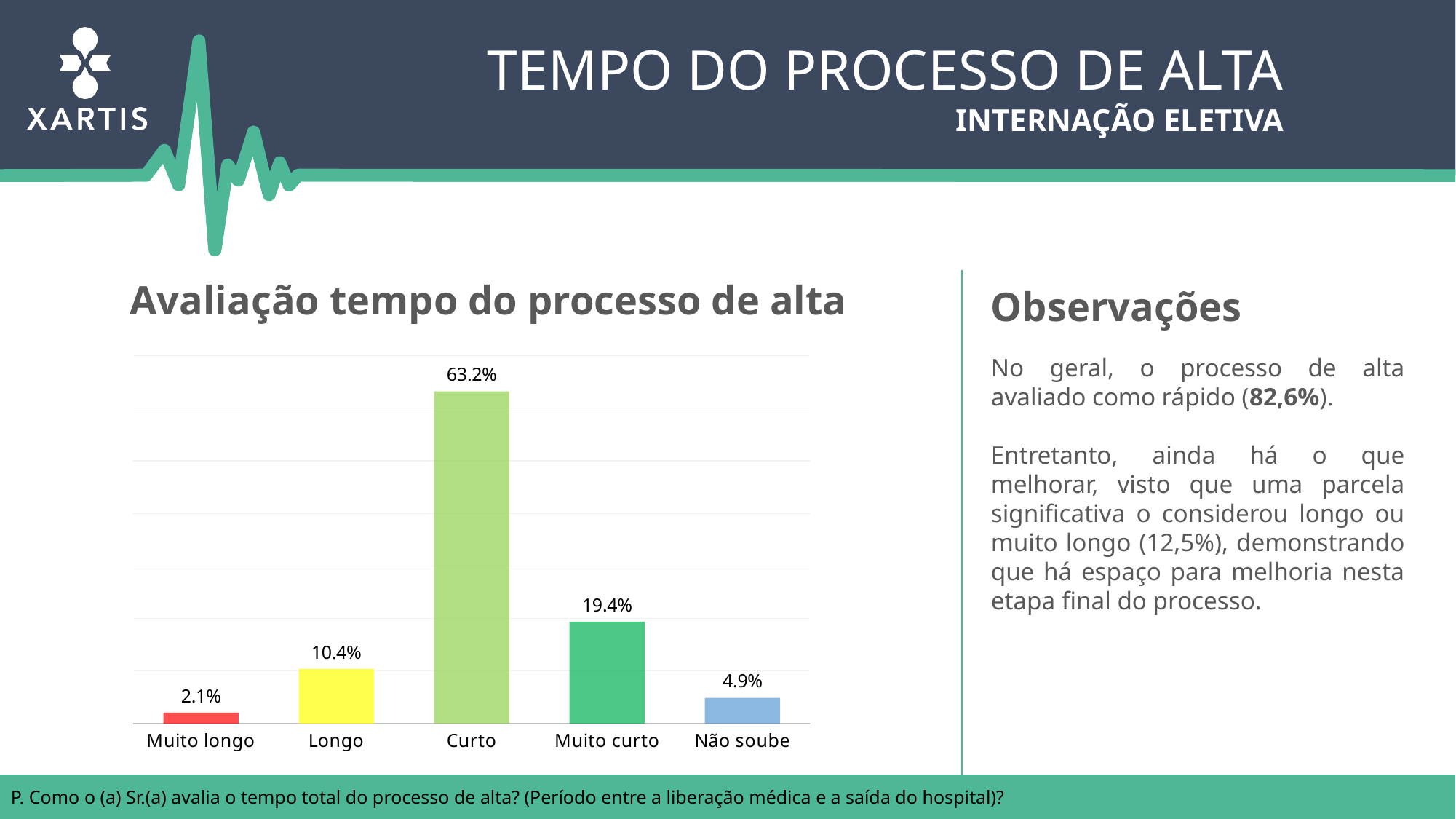
Which category has the highest value? Curto What is the difference between the values for Curto and Muito curto? 43.8% What is the value for Muito longo? 2.1% Which category has the lowest value? Muito longo What is the value for Curto? 63.2% What is the difference between the values for Longo and Muito longo? 8.3% What colour is the bar for Muito longo? Red What is the value for Não soube? 4.9% What kind of chart is shown on the slide? Bar chart Which is larger, the value for Longo or the value for Não soube? Longo How many categories are shown on the x axis? 5 What is the title of the chart? Avaliação tempo do processo de alta